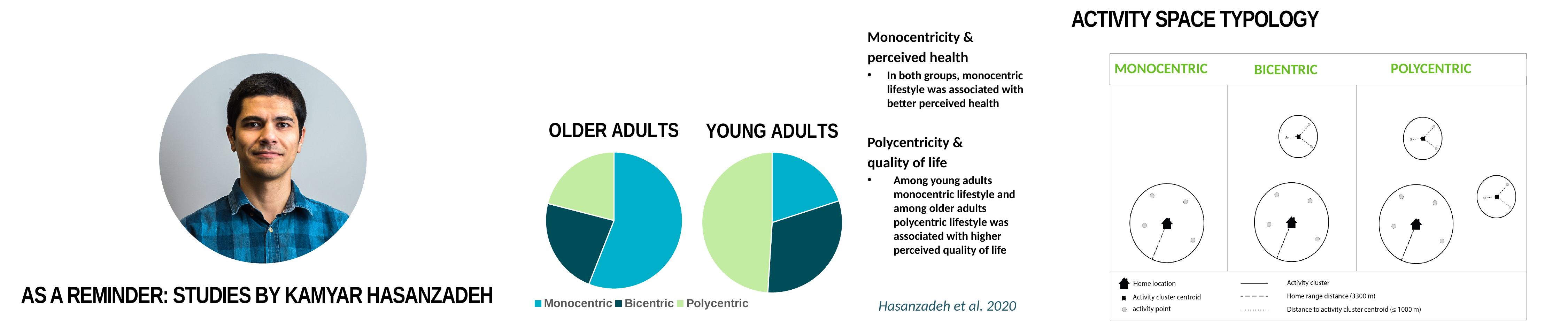
How many entries does the legend shared by the two pie charts list? 3 In the YOUNG ADULTS pie chart, which is larger: the Polycentric slice or the Monocentric slice? Polycentric In the OLDER ADULTS pie chart, which is larger: the Monocentric slice or the Bicentric slice? Monocentric In the OLDER ADULTS pie chart, which category has the largest slice? Monocentric Is the Polycentric slice larger in the YOUNG ADULTS chart or the OLDER ADULTS chart? YOUNG ADULTS What colour represents Polycentric in the pie charts? Light green What kind of chart is the OLDER ADULTS chart? Pie chart What are the legend entries for the two pie charts? Monocentric, Bicentric, Polycentric In the YOUNG ADULTS pie chart, which category has the largest slice? Polycentric How many slices does the YOUNG ADULTS pie chart have? 3